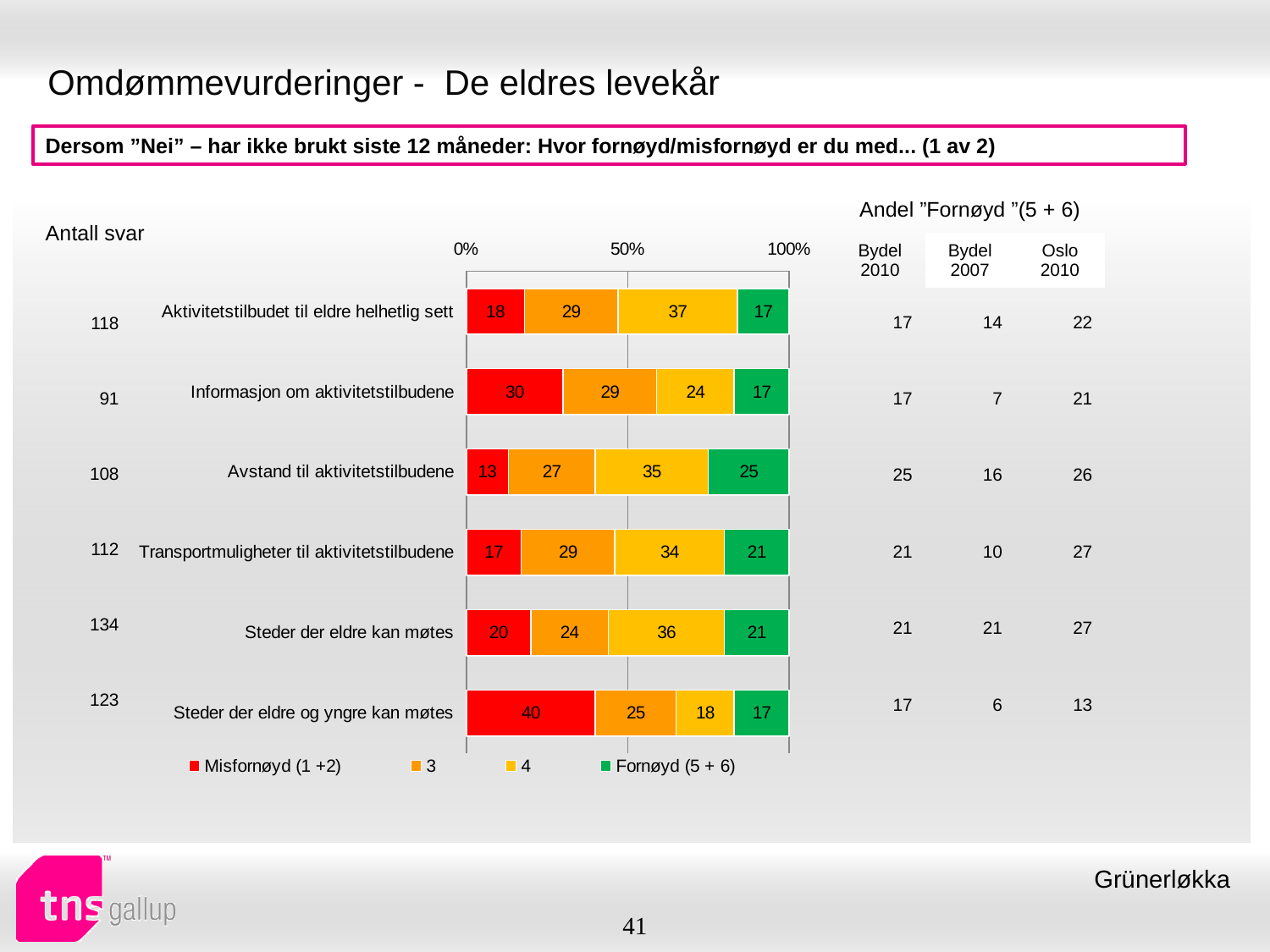
What kind of chart is shown on the slide? Stacked bar chart What is the Misfornøyd (1 +2) value for 'Steder der eldre og yngre kan møtes'? 40 How many series does the chart legend list? 4 How many categories are plotted in the chart? 6 What is the difference between the Misfornøyd (1 +2) values for 'Steder der eldre og yngre kan møtes' and 'Informasjon om aktivitetstilbudene'? 10 What is the Fornøyd (5 + 6) value for 'Avstand til aktivitetstilbudene'? 25 Which category has the highest Misfornøyd (1 +2) value? Steder der eldre og yngre kan møtes What is the value of series '4' for 'Aktivitetstilbudet til eldre helhetlig sett'? 37 What is the total of the stacked bar for 'Informasjon om aktivitetstilbudene'? 100 Which category has the lowest Misfornøyd (1 +2) value? Avstand til aktivitetstilbudene Which is larger: the series '4' value for 'Steder der eldre kan møtes' or for 'Steder der eldre og yngre kan møtes'? Steder der eldre kan møtes Which category has the highest Fornøyd (5 + 6) value? Avstand til aktivitetstilbudene